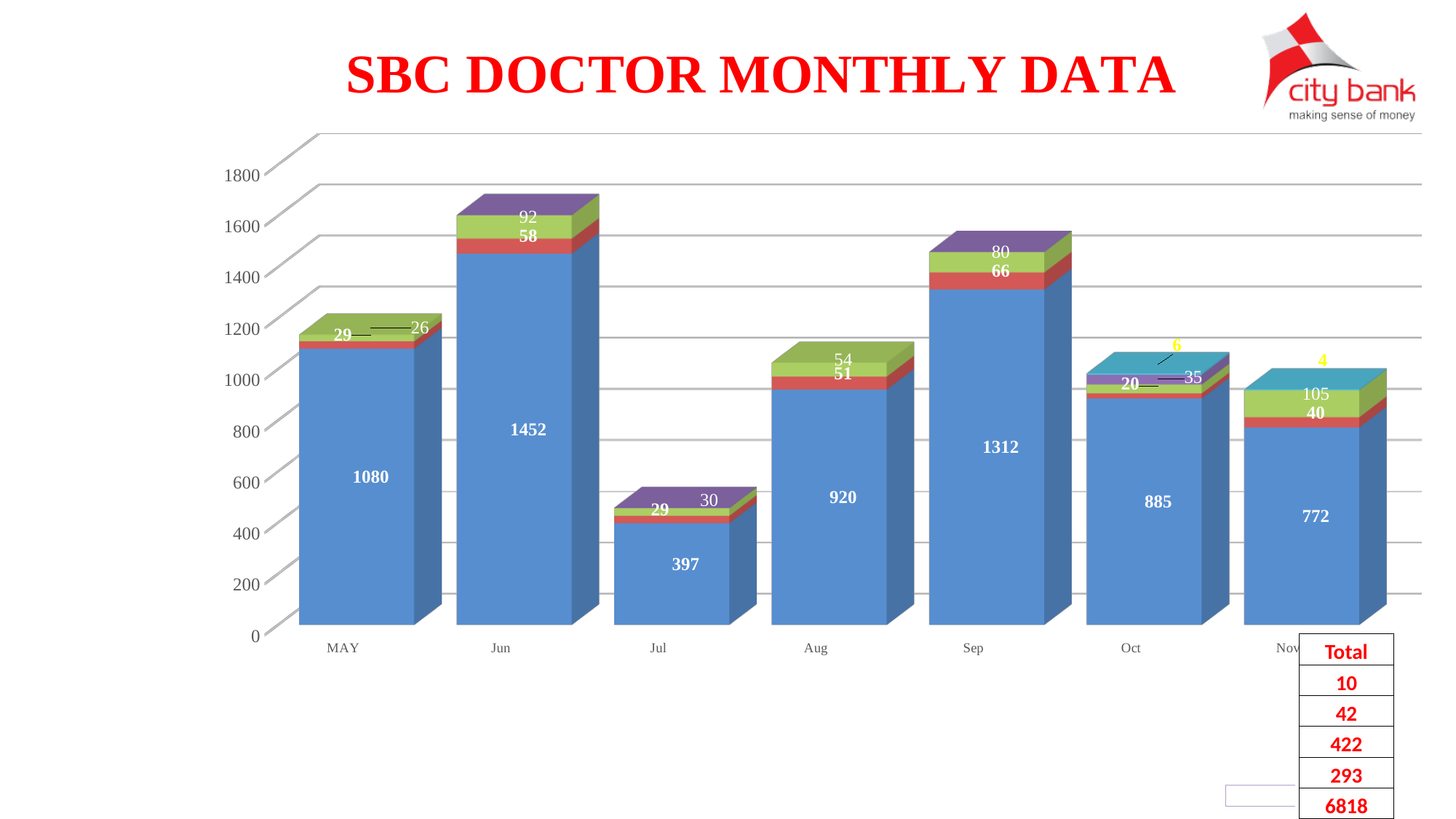
What is the value of the blue segment for Jul? 397 What is the title of the chart? SBC DOCTOR MONTHLY DATA How many months are shown on the x axis? 7 Which is larger, the blue segment for Aug or the blue segment for Oct? Aug Which month has the lowest value in the blue segment? Jul What is the value of the blue segment for Jun? 1452 What is the difference between the blue segment values for Jun and Jul? 1055 Is the total height of the Jul bar greater or less than 600? less What kind of chart is shown on the slide? Stacked bar chart Which month has the highest value in the blue segment? Jun What is the value of the red segment for Sep? 66 What is the value of the green segment for Nov? 105